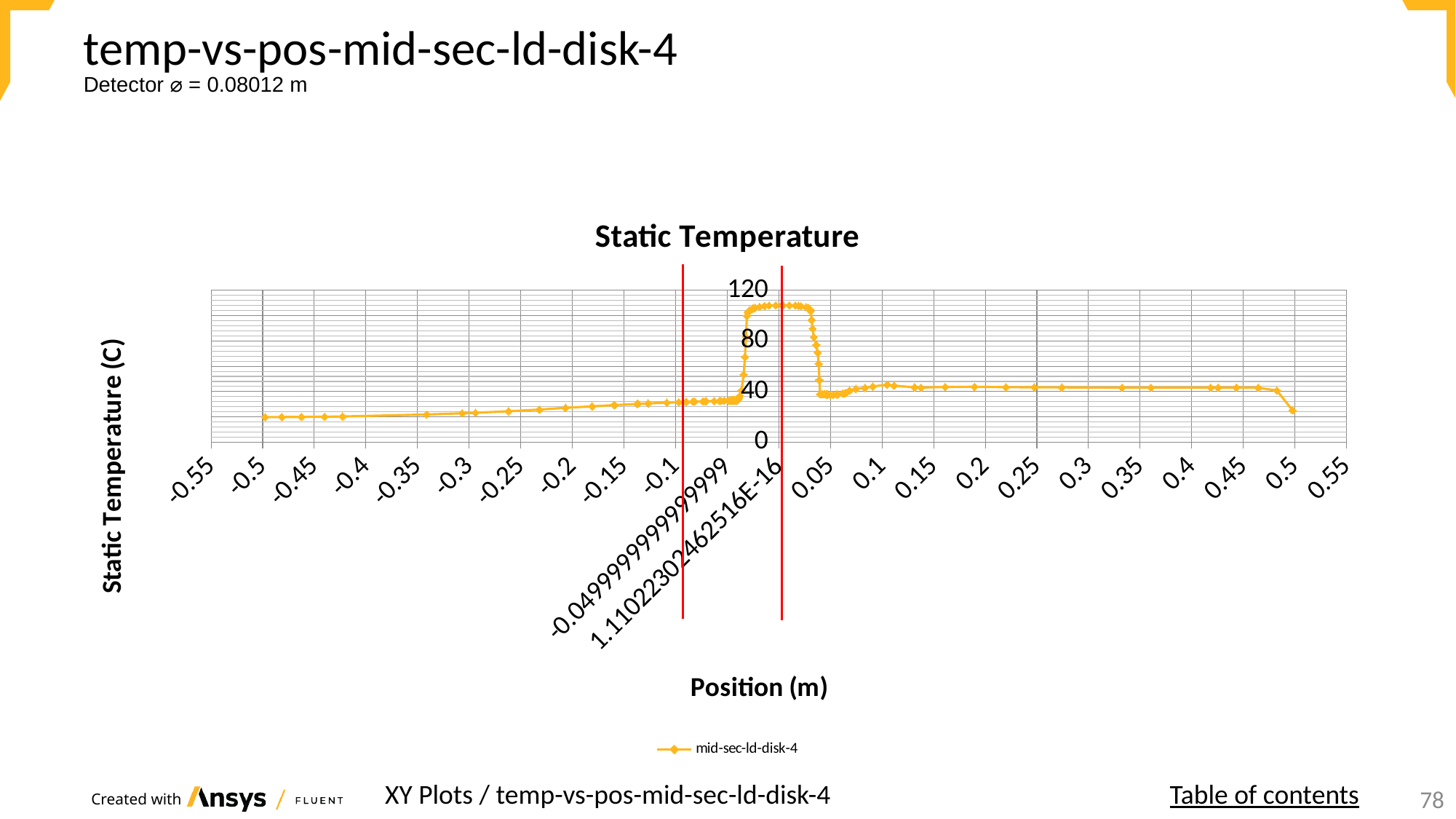
Is the value for position -0.3 greater or less than 40? less How many series does the legend list? 1 Do the values rise or fall along the x axis between position -0.5 and position -0.1? rise Is the value for position 0.5 greater or less than 40? less Is the value for position -0.5 greater or less than 40? less What is the name of the series in the legend? mid-sec-ld-disk-4 What kind of chart is shown on the slide? line chart Which is larger, the value at position 1.11022302462516E-16 or the value at position 0.3? 1.11022302462516E-16 Do the values rise or fall along the x axis between position 0.45 and position 0.5? fall Which is larger, the value at position -0.5 or the value at position 0.3? 0.3 What is the title of the chart? Static Temperature